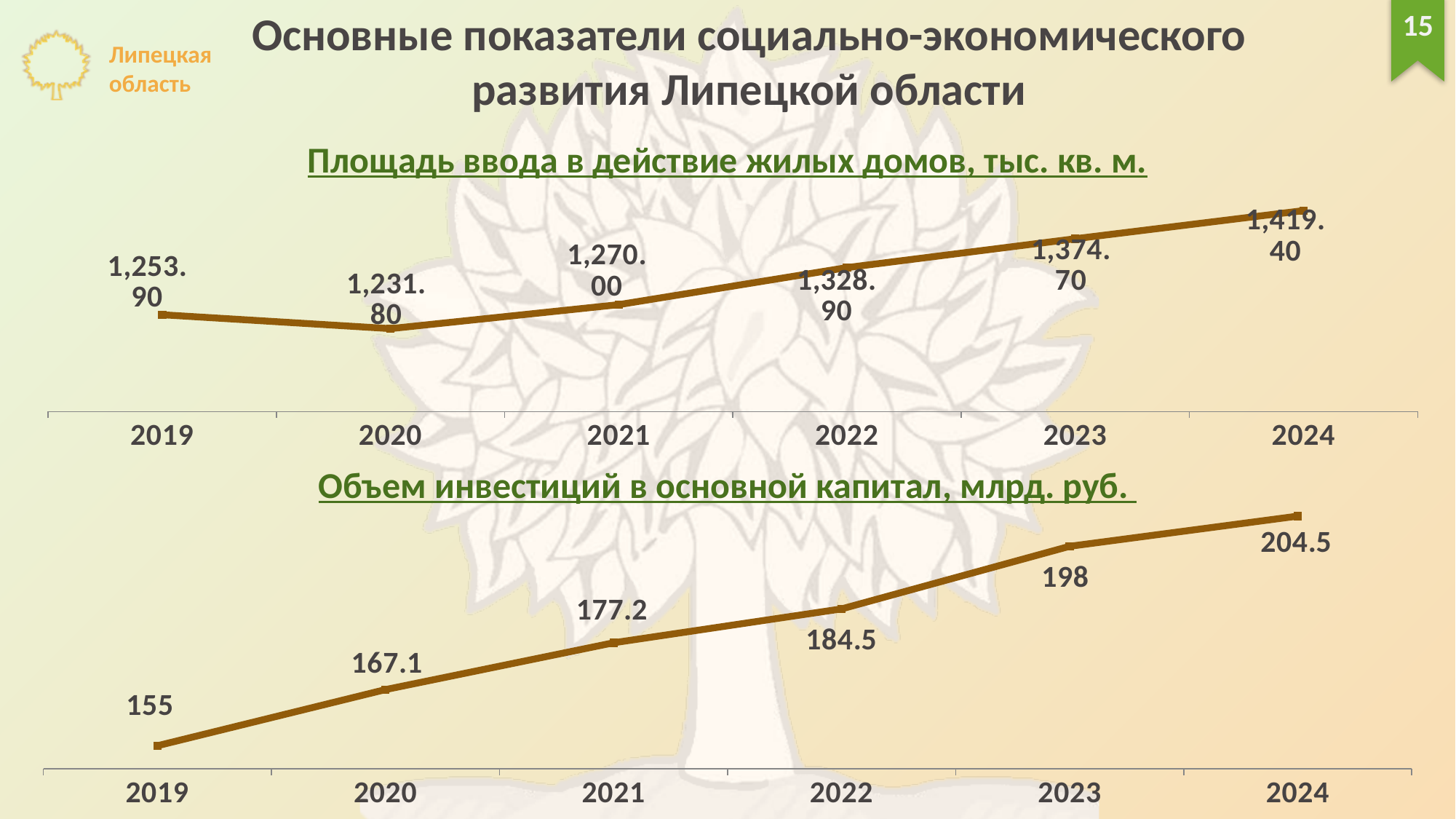
In the chart 'Площадь ввода в действие жилых домов, тыс. кв. м.', what is the difference between the 2024 and 2019 values? 165.50 In the chart 'Объем инвестиций в основной капитал, млрд. руб.', do the values rise or fall from 2019 to 2024? rise In the chart 'Площадь ввода в действие жилых домов, тыс. кв. м.', which year has the highest value? 2024 In the chart 'Площадь ввода в действие жилых домов, тыс. кв. м.', is the value for 2019 or 2020 larger? 2019 In the chart 'Площадь ввода в действие жилых домов, тыс. кв. м.', which year has the lowest value? 2020 In the chart 'Объем инвестиций в основной капитал, млрд. руб.', what is the difference between the 2023 and 2022 values? 13.5 What kind of chart is the top chart on the slide? line chart How many years are plotted in the chart 'Объем инвестиций в основной капитал, млрд. руб.'? 6 In the chart 'Площадь ввода в действие жилых домов, тыс. кв. м.', what is the value for 2022? 1,328.90 In the chart 'Объем инвестиций в основной капитал, млрд. руб.', what is the value for 2019? 155 What is the title of the bottom chart on the slide? Объем инвестиций в основной капитал, млрд. руб. In the chart 'Объем инвестиций в основной капитал, млрд. руб.', what is the value for 2021? 177.2